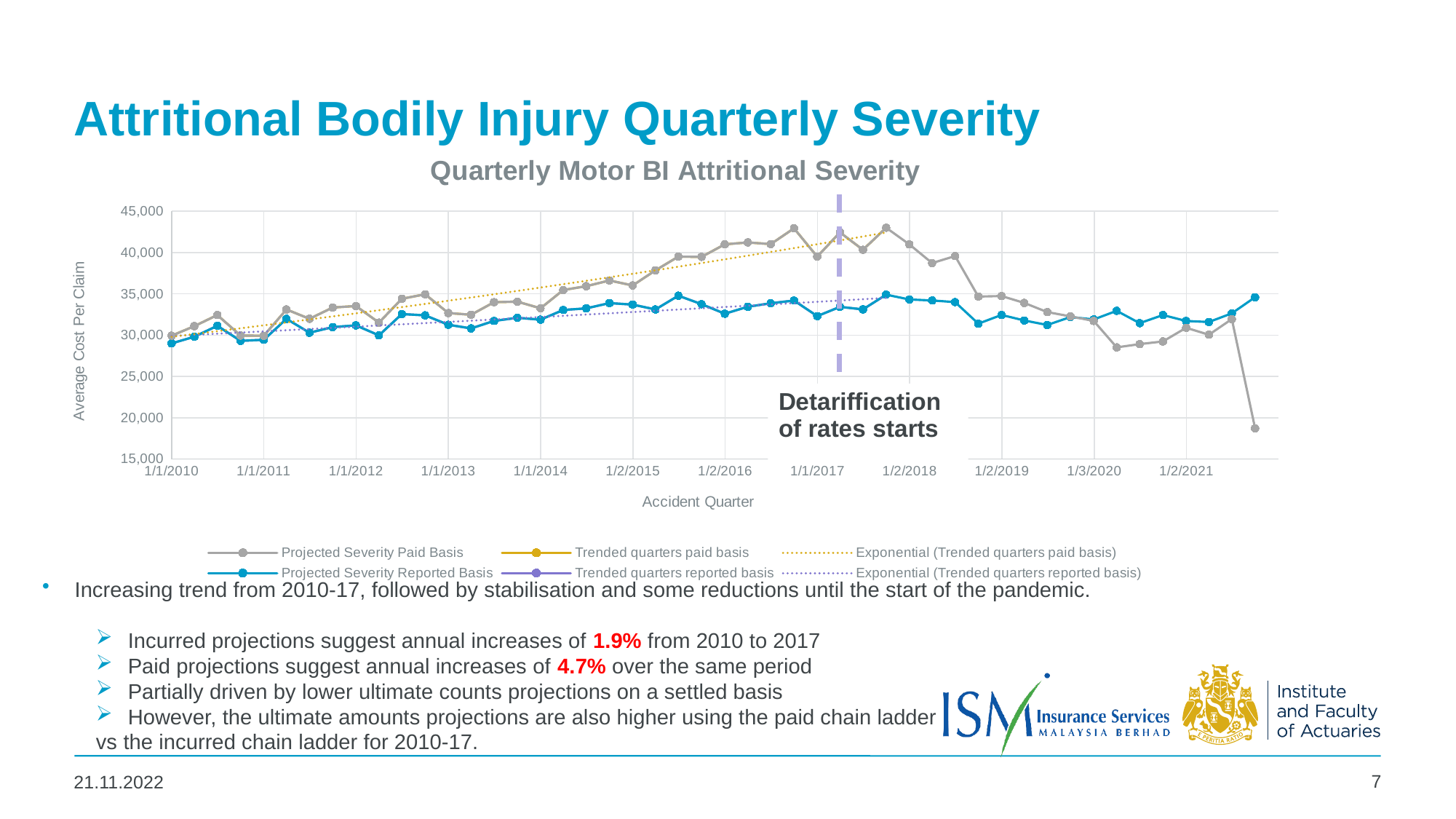
What kind of chart is shown on the slide? Line chart Does the Projected Severity Paid Basis series generally rise or fall between 1/2/2018 and 1/3/2020? Fall Is the value of Projected Severity Reported Basis at 1/2/2016 greater or less than 35,000? less Does the Projected Severity Paid Basis series generally rise or fall between 1/1/2010 and 1/1/2017? Rise Is the value of Projected Severity Paid Basis at 1/2/2016 greater or less than 40,000? greater How many series does the chart legend list? 6 What does the vertical dashed line on the chart mark, according to its label? Detariffication of rates starts Is the value of Projected Severity Paid Basis at 1/2/2018 greater or less than 40,000? greater At 1/2/2016, which series has the higher value: Projected Severity Paid Basis or Projected Severity Reported Basis? Projected Severity Paid Basis What is the title of the chart? Quarterly Motor BI Attritional Severity